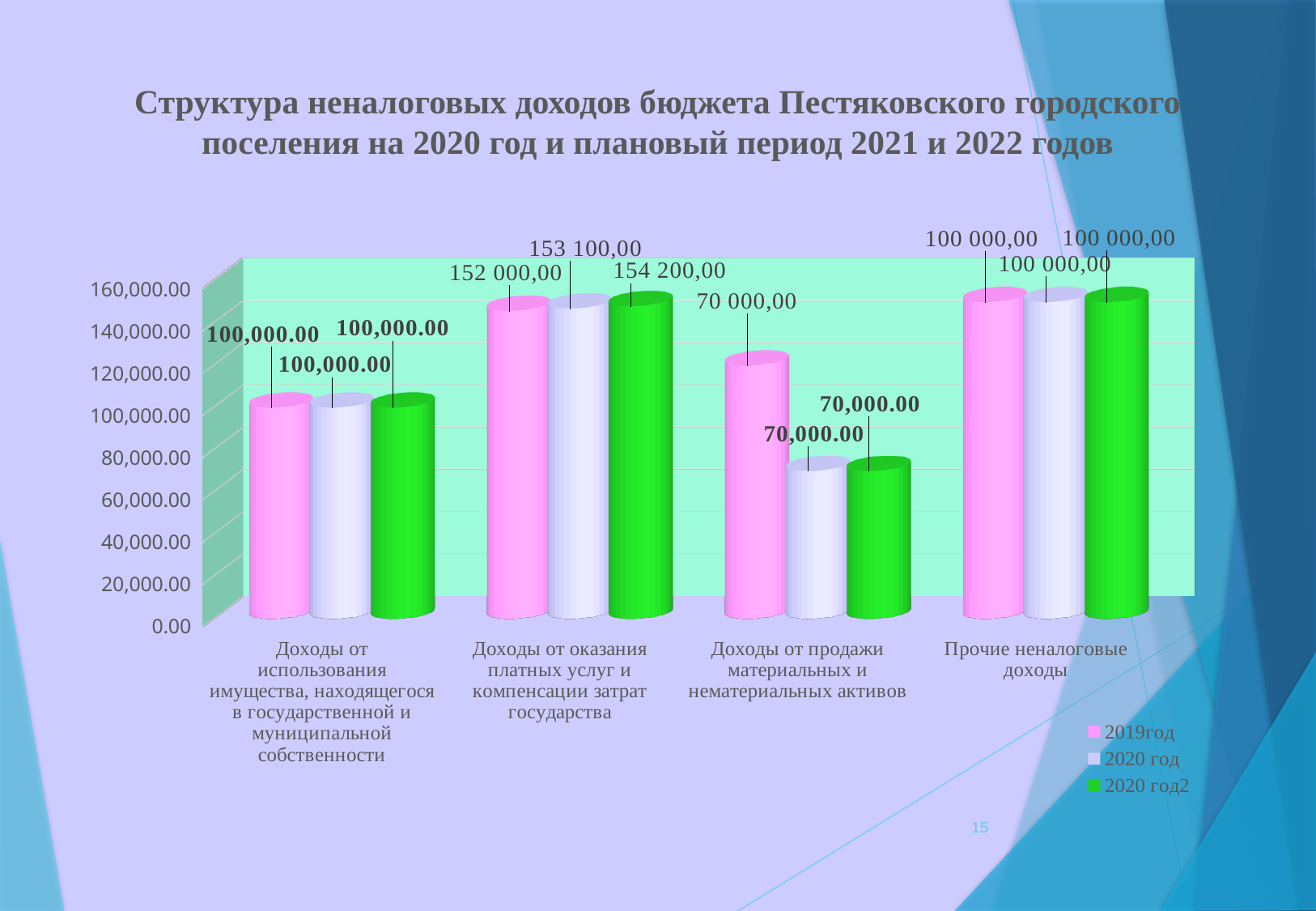
How many series does the chart legend list? 3 Which series is shown in green in the legend? 2020 год2 Which category has the lowest values across all series? Доходы от продажи материальных и нематериальных активов What is the value of the 2019год series for 'Доходы от продажи материальных и нематериальных активов'? 70 000,00 What is the difference between the 2020 год2 value and the 2019год value for 'Доходы от оказания платных услуг и компенсации затрат государства'? 2 200,00 What is the value of the 2020 год series for 'Доходы от оказания платных услуг и компенсации затрат государства'? 153 100,00 What is the value of the 2020 год2 series for 'Прочие неналоговые доходы'? 100 000,00 What is the value of the 2020 год2 series for 'Доходы от оказания платных услуг и компенсации затрат государства'? 154 200,00 What kind of chart is shown on the slide? bar chart How many categories are shown on the x axis of the chart? 4 What is the value of the 2019год series for 'Доходы от оказания платных услуг и компенсации затрат государства'? 152 000,00